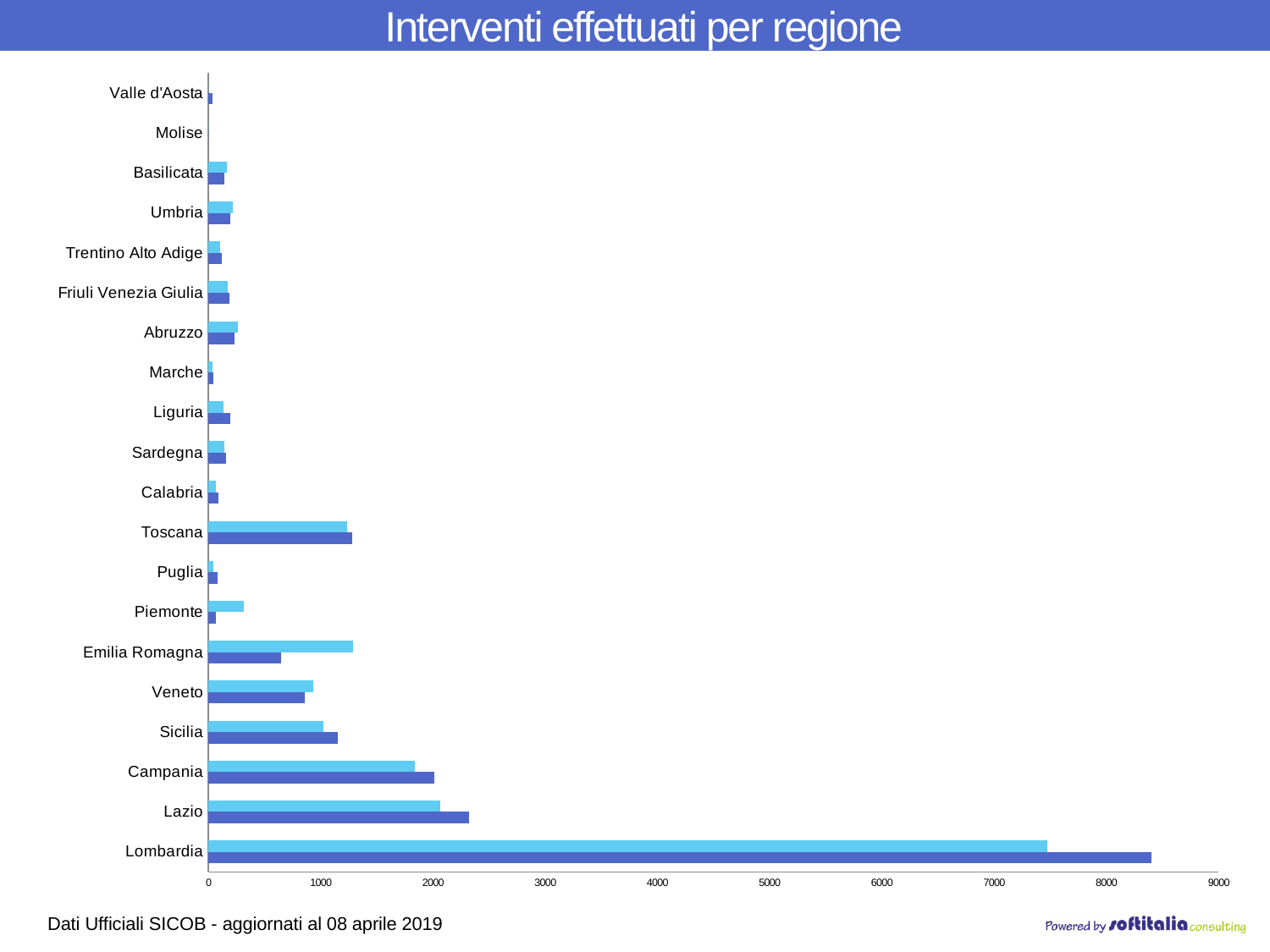
Is the dark blue bar for Emilia Romagna greater or less than 1000? less Which region has the larger dark blue bar, Lombardia or Lazio? Lombardia Which region has the lowest values on the chart? Molise Is the dark blue bar for Lazio greater or less than 2000? greater How many regions are listed on the chart? 20 Is the dark blue bar for Lombardia greater or less than 8000? greater What is the title of the chart? Interventi effettuati per regione Which region has the highest values on the chart? Lombardia For Emilia Romagna, which bar is longer, the light blue one or the dark blue one? the light blue one What kind of chart is shown on the slide? bar chart